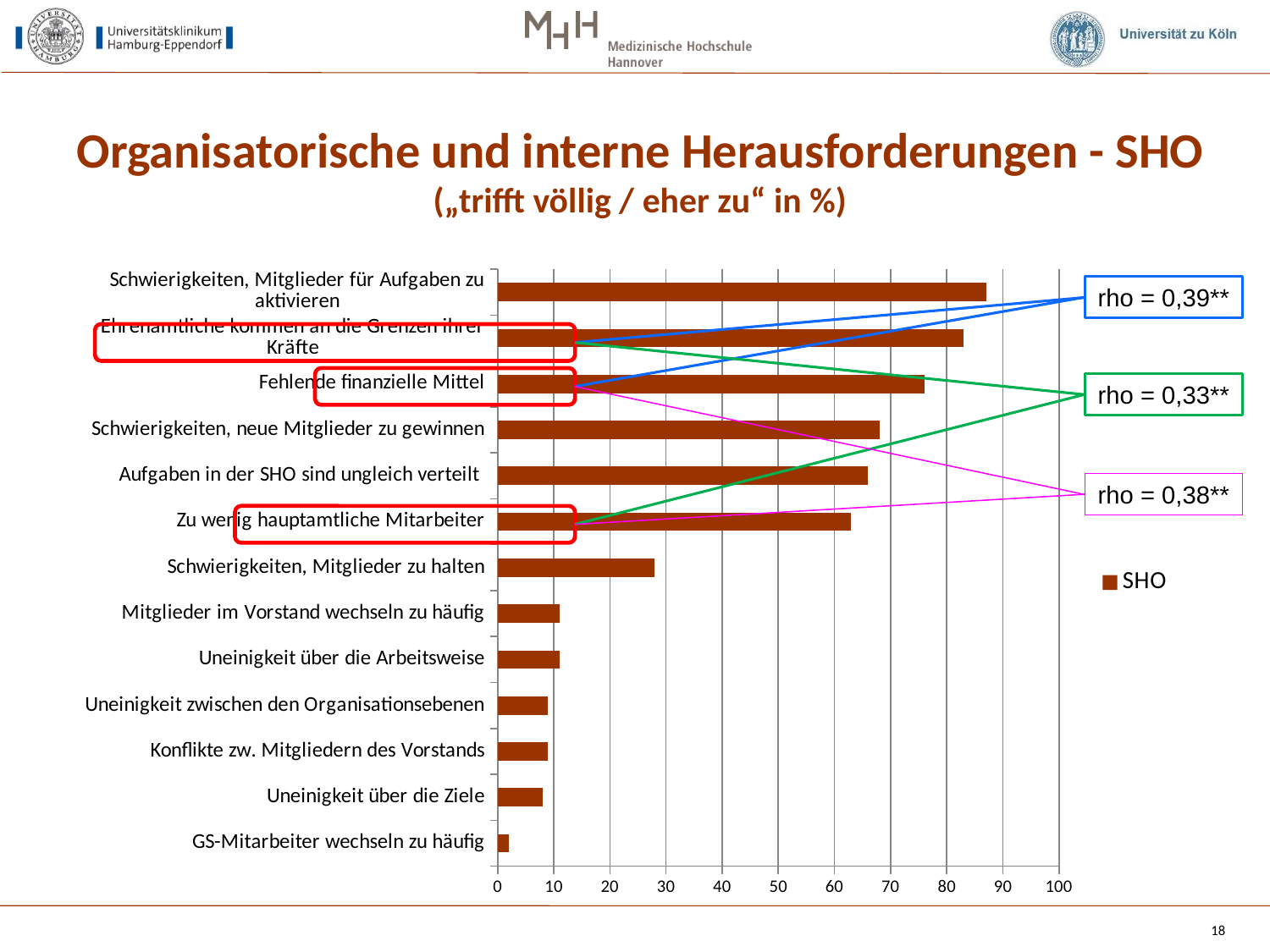
Is the value for "Schwierigkeiten, neue Mitglieder zu gewinnen" greater or less than 60? greater Is the value for "Uneinigkeit über die Ziele" greater or less than 10? less Is the value for "Schwierigkeiten, Mitglieder zu halten" greater or less than 40? less Which has the larger value: "Ehrenamtliche kommen an die Grenzen ihrer Kräfte" or "Fehlende finanzielle Mittel"? Ehrenamtliche kommen an die Grenzen ihrer Kräfte What is the name of the series shown in the legend? SHO Which category has the lowest value? GS-Mitarbeiter wechseln zu häufig How many series does the legend list? 1 What kind of chart is shown on the slide? bar chart Which has the larger value: "Zu wenig hauptamtliche Mitarbeiter" or "Schwierigkeiten, Mitglieder zu halten"? Zu wenig hauptamtliche Mitarbeiter Which category has the highest value? Schwierigkeiten, Mitglieder für Aufgaben zu aktivieren How many categories are plotted in the chart? 13